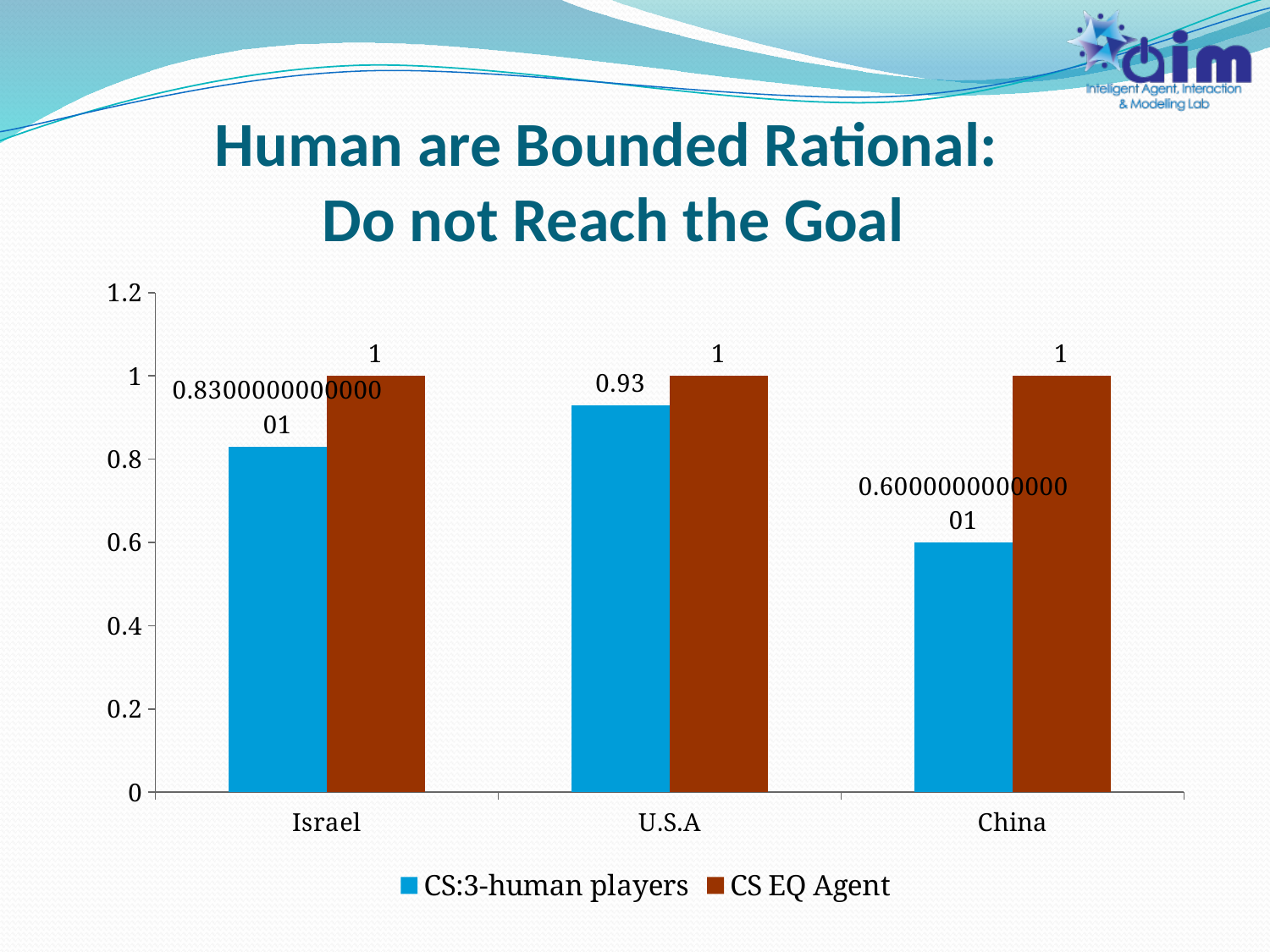
What kind of chart is shown on the slide? bar chart What is the value for CS EQ Agent for Israel? 1 What are the two entries in the chart's legend? CS:3-human players and CS EQ Agent How many countries are shown on the x axis of the chart? 3 What is the value for CS:3-human players for U.S.A? 0.93 Which country has the lowest value for CS:3-human players? China Is the CS:3-human players value for China greater or less than 0.8? less What is the value for CS EQ Agent for China? 1 Which country has the highest value for CS:3-human players? U.S.A How many series does the chart's legend list? 2 Which is larger: the CS:3-human players value for Israel or for China? Israel For U.S.A, what is the difference between the CS EQ Agent value and the CS:3-human players value? 0.07